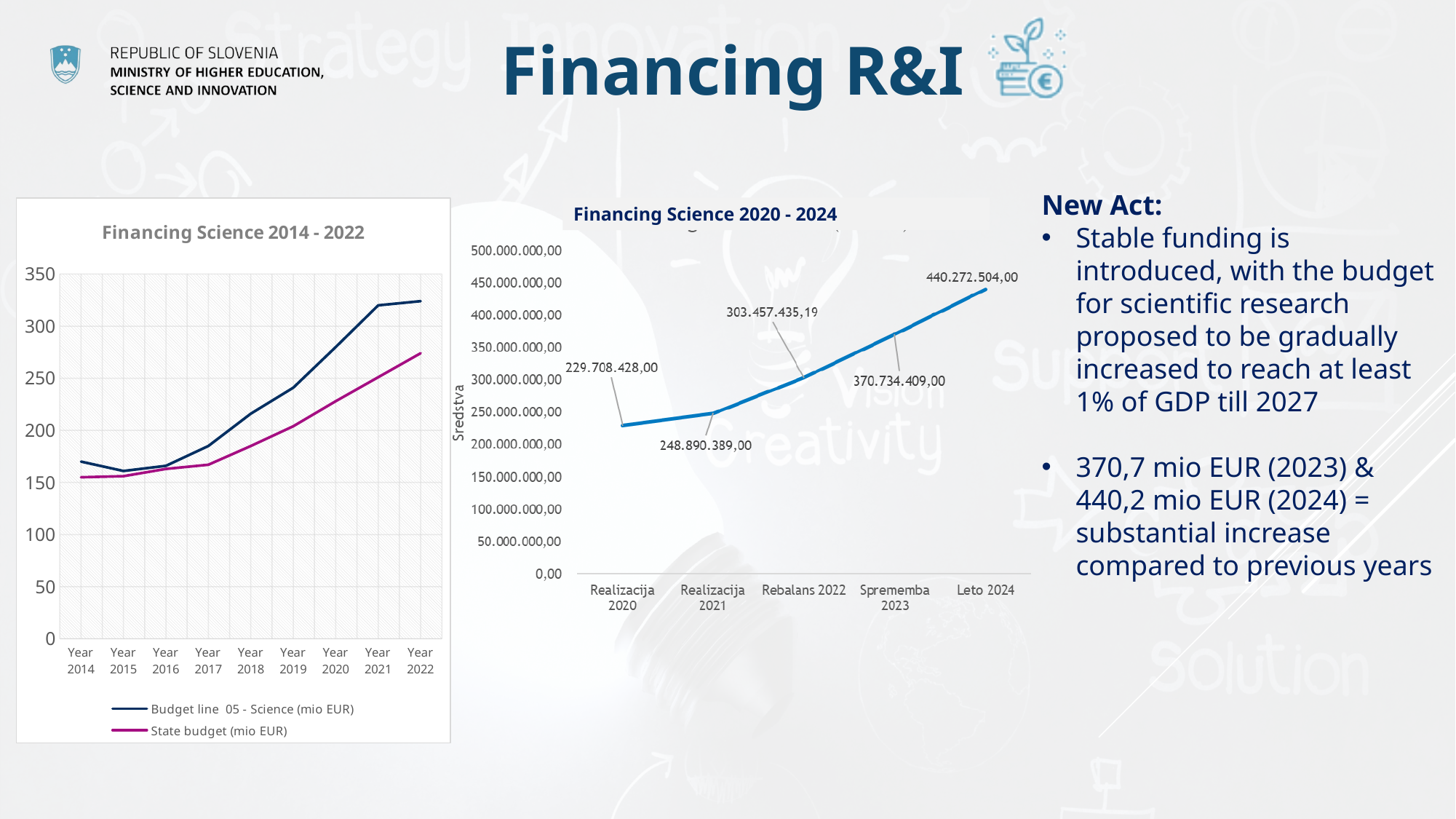
On the 'Financing Science 2020 - 2024' chart, what is the value for Leto 2024? 440.272.504,00 On the 'Financing Science 2014 - 2022' chart, is the value for Budget line 05 - Science in Year 2022 greater or less than 300? greater On the 'Financing Science 2020 - 2024' chart, which category has the lowest value? Realizacija 2020 On the 'Financing Science 2014 - 2022' chart, which series is higher in Year 2021, Budget line 05 - Science or State budget? Budget line 05 - Science (mio EUR) On the 'Financing Science 2014 - 2022' chart, how many series does the legend list? 2 On the 'Financing Science 2020 - 2024' chart, what is the difference between the values for Leto 2024 and Sprememba 2023? 69.538.095,00 On the 'Financing Science 2020 - 2024' chart, what is the value for Realizacija 2020? 229.708.428,00 On the 'Financing Science 2020 - 2024' chart, what is the label of the y axis? Sredstva What kind of chart is the 'Financing Science 2014 - 2022' chart? line chart On the 'Financing Science 2020 - 2024' chart, what is the value for Rebalans 2022? 303.457.435,19 On the 'Financing Science 2020 - 2024' chart, do the values rise or fall from Realizacija 2020 to Leto 2024? rise On the 'Financing Science 2020 - 2024' chart, how many categories are shown on the x axis? 5